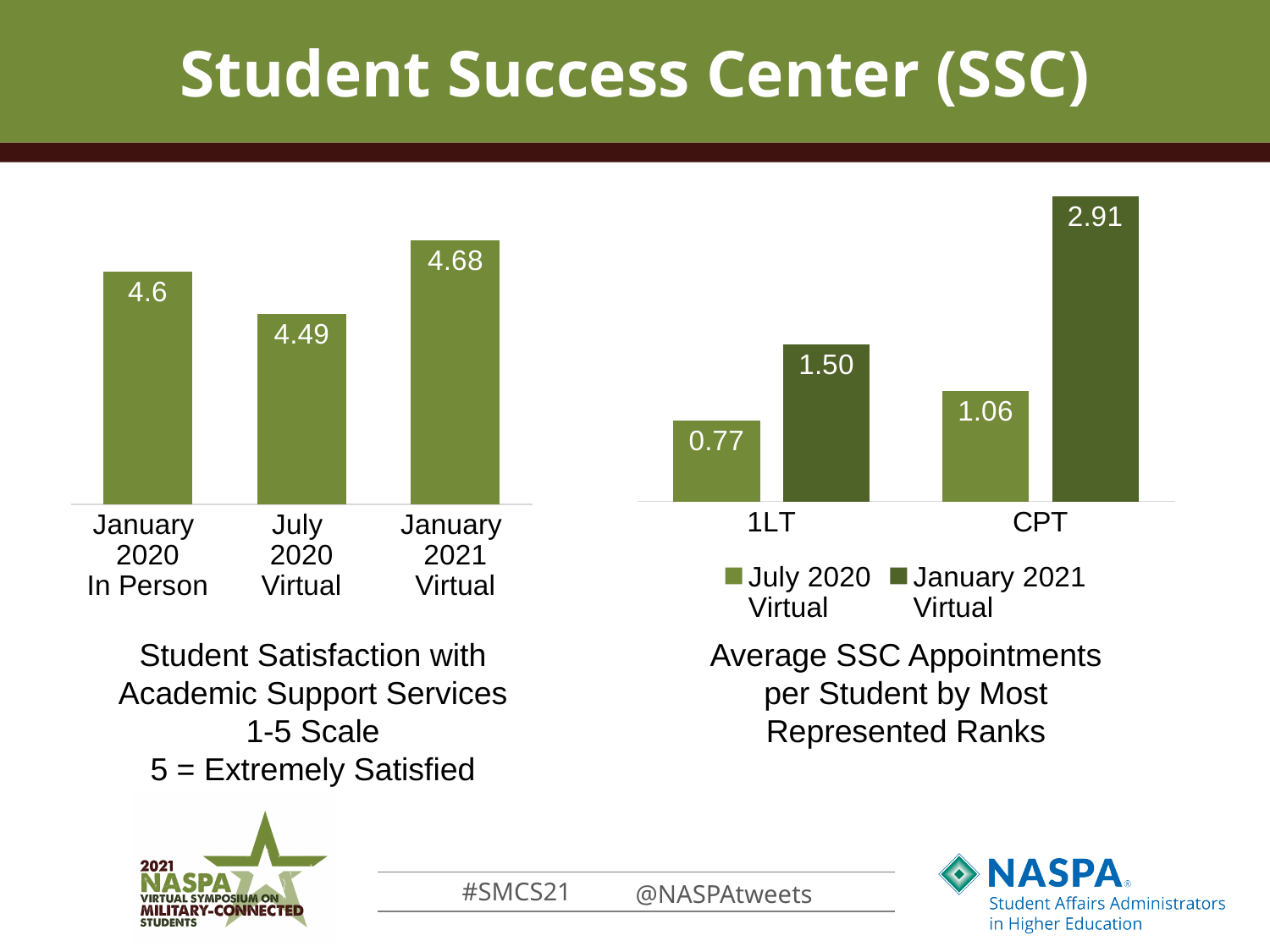
In the right chart (Average SSC Appointments per Student), which is larger: the July 2020 Virtual value for 1LT or for CPT? CPT In the left chart (Student Satisfaction with Academic Support Services), which period has the highest satisfaction score? January 2021 Virtual In the left chart (Student Satisfaction with Academic Support Services), which period has the lowest satisfaction score? July 2020 Virtual In the right chart (Average SSC Appointments per Student), what is the difference between the January 2021 Virtual and July 2020 Virtual values for CPT? 1.85 In the left chart (Student Satisfaction with Academic Support Services), what is the value for July 2020 Virtual? 4.49 In the left chart (Student Satisfaction with Academic Support Services), what is the difference between the January 2021 Virtual and January 2020 In Person values? 0.08 In the right chart (Average SSC Appointments per Student), which rank and period combination has the highest value? CPT, January 2021 Virtual In the right chart (Average SSC Appointments per Student), what is the July 2020 Virtual value for CPT? 1.06 In the right chart (Average SSC Appointments per Student), how many series does the legend list? 2 What kind of chart is the right chart (Average SSC Appointments per Student)? Bar chart In the left chart (Student Satisfaction with Academic Support Services), how many periods are shown? 3 In the right chart (Average SSC Appointments per Student), what is the January 2021 Virtual value for 1LT? 1.50